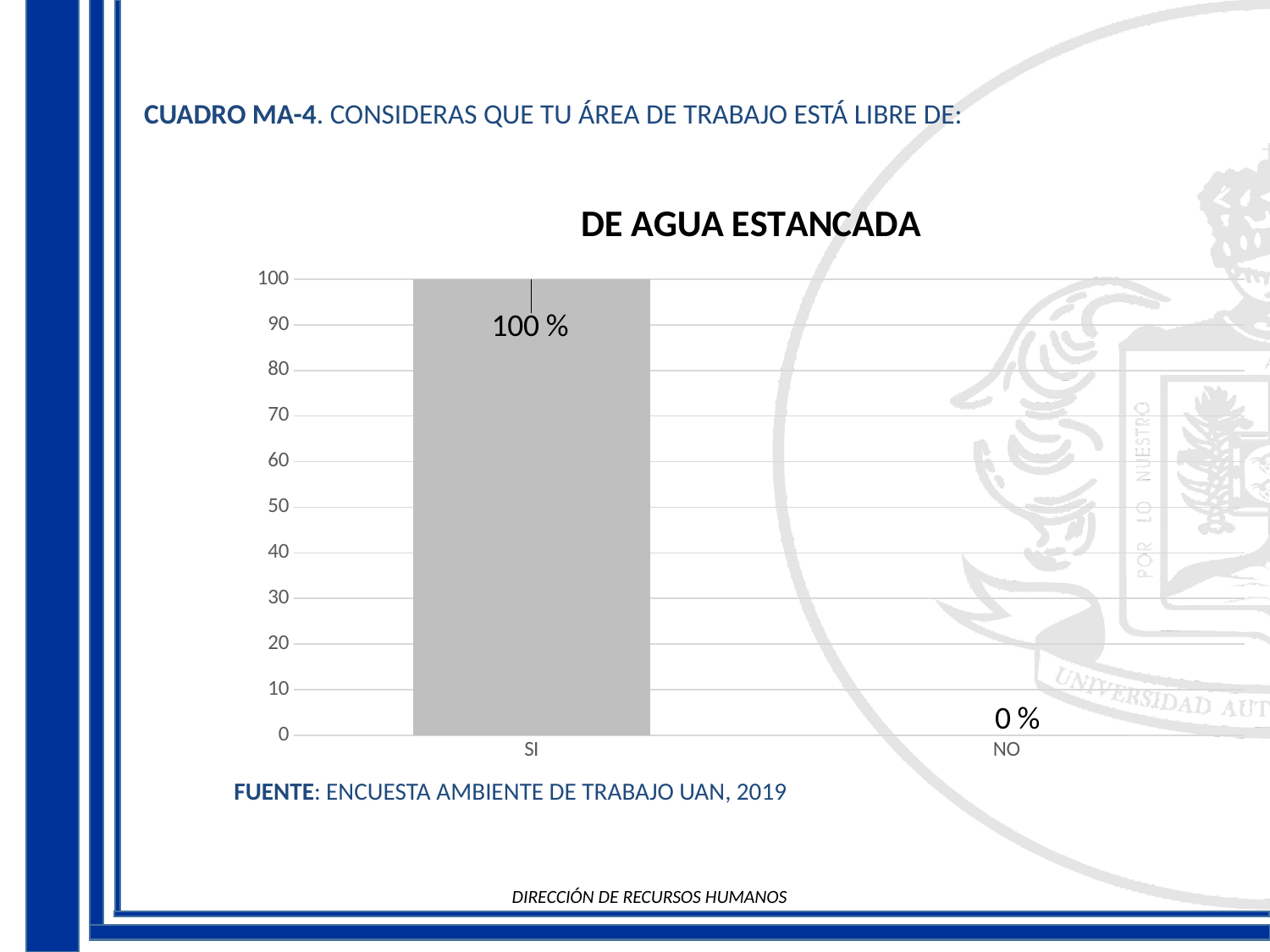
Which is larger, the value for SI or the value for NO? SI What is the value for SI? 100 % Do the values rise or fall from SI to NO along the x axis? fall What kind of chart is shown on the slide? bar chart Which category has the highest value? SI What is the highest value shown on the vertical axis? 100 Which category has the lowest value? NO How many categories are shown on the x axis? 2 What is the value for NO? 0 % What is the title of the chart? DE AGUA ESTANCADA What is the difference between the values for SI and NO? 100 % Is the value for SI greater or less than 50? greater